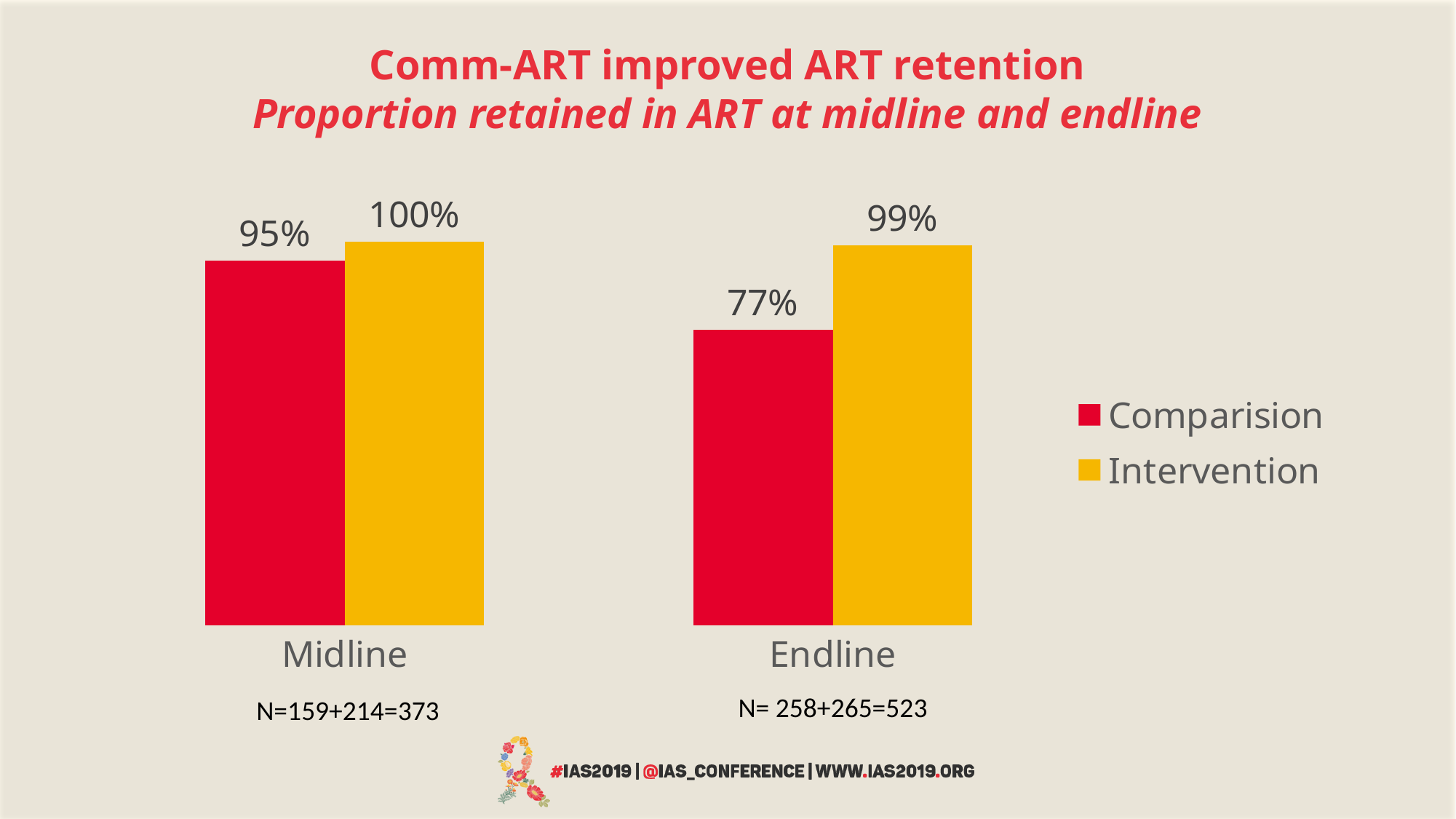
What is the value for Comparision at Midline? 95% How many series does the legend list? 2 What is the value for Intervention at Endline? 99% Does the Comparision value rise or fall from Midline to Endline? Fall What is the difference between the Comparision values at Midline and Endline? 18% Which bar has the highest value on the chart? Intervention at Midline What is the value for Intervention at Midline? 100% Which group has the lowest value at Endline? Comparision Which is larger, the Comparision value at Midline or the Comparision value at Endline? Midline What is the value for Comparision at Endline? 77% What is the difference between the Intervention and Comparision values at Endline? 22% What kind of chart is shown on the slide? Bar chart